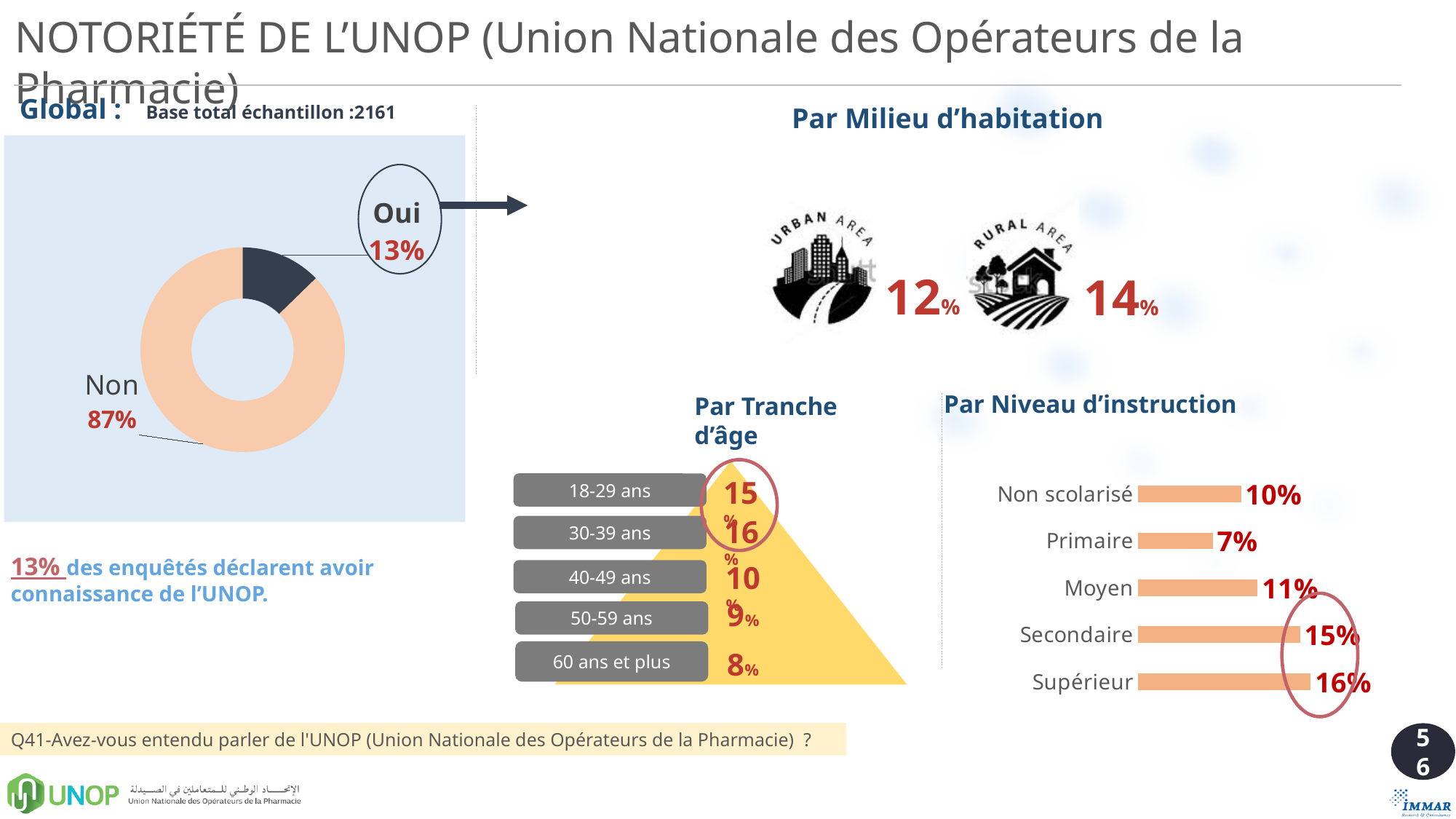
In the "Par Niveau d'instruction" chart, what is the difference between Supérieur and Non scolarisé? 6% In the Global donut chart, what percentage of respondents answered "Non"? 87% What type of chart is used for the Global section on the left of the slide? Donut chart In the Global donut chart, what percentage of respondents answered "Oui"? 13% In the Global donut chart, how many categories are shown? 2 In the "Par Niveau d'instruction" chart, what is the value for Primaire? 7% In the "Par Tranche d'âge" section, what is the value for 60 ans et plus? 8% In the "Par Niveau d'instruction" chart, how many categories are plotted? 5 In the "Par Niveau d'instruction" chart, which is larger, Moyen or Secondaire? Secondaire What type of chart is the "Par Niveau d'instruction" chart? Bar chart In the "Par Niveau d'instruction" chart, which category has the highest value? Supérieur In the "Par Niveau d'instruction" chart, which category has the lowest value? Primaire